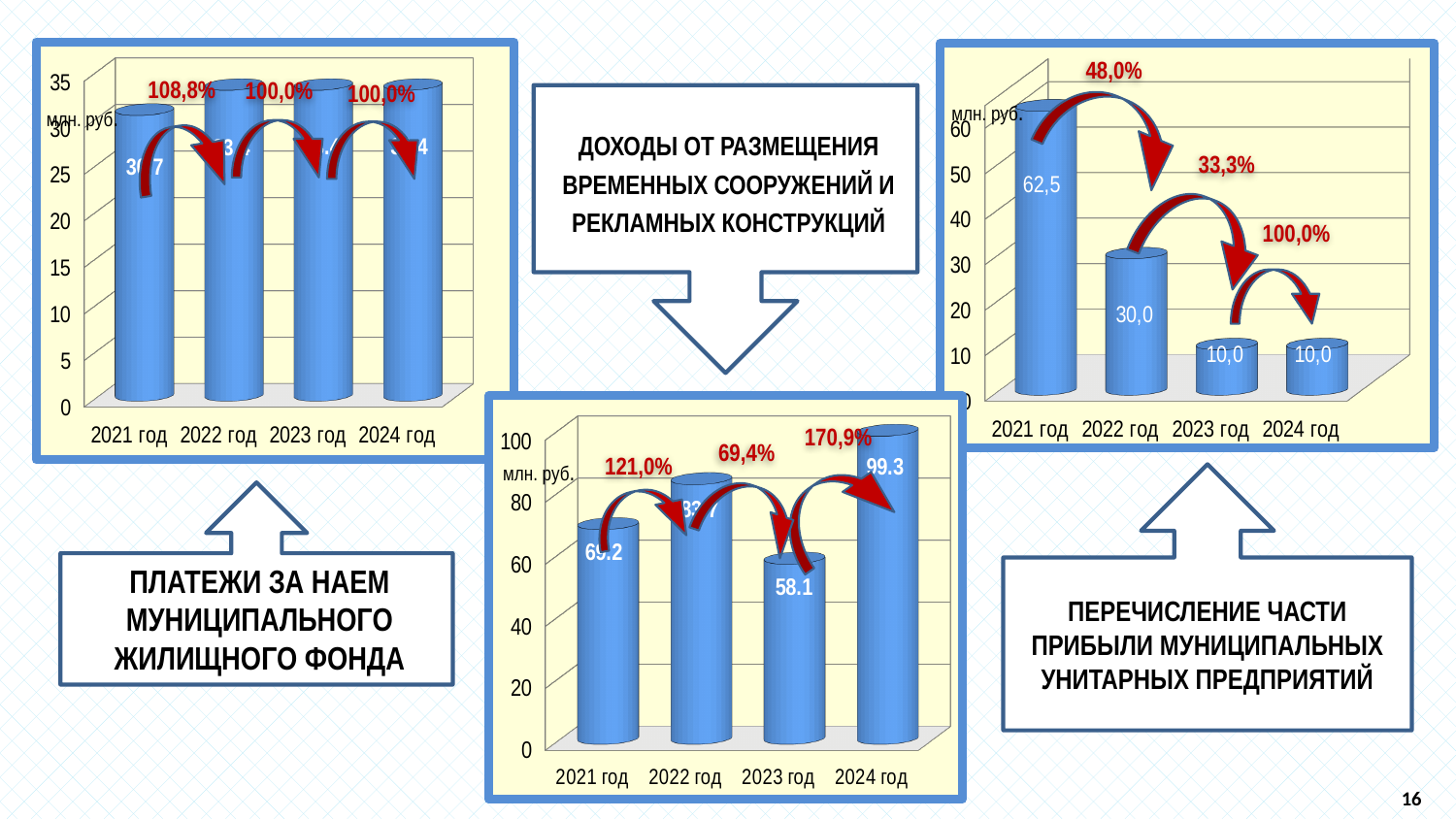
In the chart for 'Доходы от размещения временных сооружений и рекламных конструкций' (bottom centre), which year has the lowest value? 2023 год In the chart for 'Перечисление части прибыли муниципальных унитарных предприятий' (right), what is the value for 2022 год? 30,0 In the chart for 'Доходы от размещения временных сооружений и рекламных конструкций' (bottom centre), what is the value for 2023 год? 58.1 In the chart for 'Доходы от размещения временных сооружений и рекламных конструкций' (bottom centre), what is the difference between the 2024 год and 2021 год values? 30.1 In the chart for 'Перечисление части прибыли муниципальных унитарных предприятий' (right), do the values rise or fall from 2021 to 2023? fall In the chart for 'Перечисление части прибыли муниципальных унитарных предприятий' (right), what is the value for 2021 год? 62,5 How many years (categories) are shown in the chart for 'Платежи за наем муниципального жилищного фонда' (left)? 4 In the chart for 'Доходы от размещения временных сооружений и рекламных конструкций' (bottom centre), what is the value for 2024 год? 99.3 In the chart for 'Платежи за наем муниципального жилищного фонда' (left), what percentage change is shown between 2021 год and 2022 год? 108,8% In the chart for 'Платежи за наем муниципального жилищного фонда' (left), is the value for 2021 год greater or less than 25? greater In the chart for 'Перечисление части прибыли муниципальных унитарных предприятий' (right), what is the difference between the 2021 год and 2022 год values? 32,5 In the chart for 'Перечисление части прибыли муниципальных унитарных предприятий' (right), which year has the highest value? 2021 год